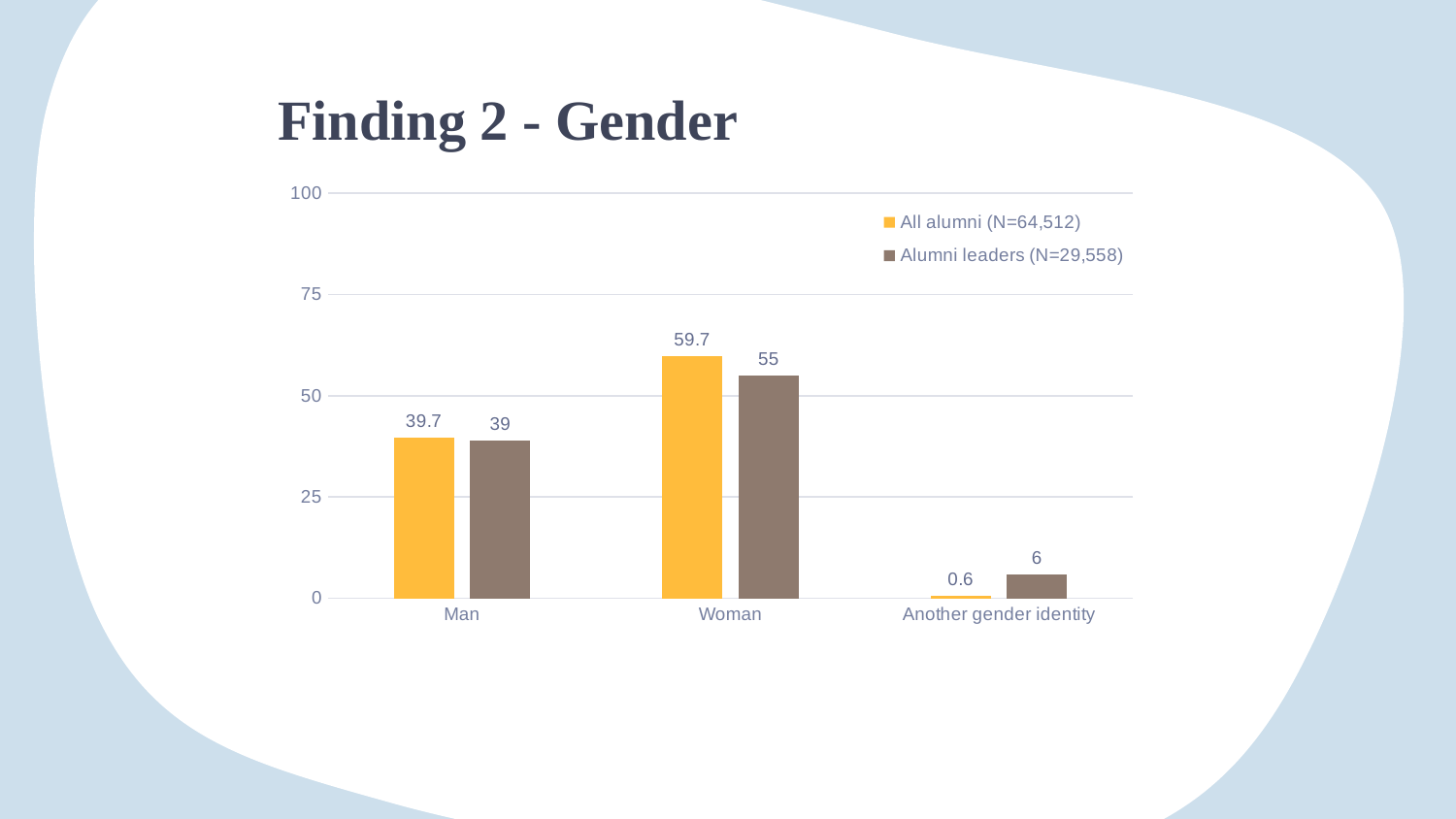
Which category has the highest value in the Alumni leaders (N=29,558) series? Woman What is the value for Another gender identity in the All alumni (N=64,512) series? 0.6 How many categories are shown on the x axis? 3 How many series does the legend list? 2 What kind of chart is shown on the slide? Bar chart What is the difference between the Alumni leaders and All alumni values for Another gender identity? 5.4 Which is larger for Man: the All alumni value or the Alumni leaders value? All alumni What is the difference between the All alumni and Alumni leaders values for Woman? 4.7 What is the value for Woman in the All alumni (N=64,512) series? 59.7 Is the value for Woman in the All alumni series greater or less than 50? greater Which category has the lowest value in the All alumni (N=64,512) series? Another gender identity What is the value for Man in the Alumni leaders (N=29,558) series? 39